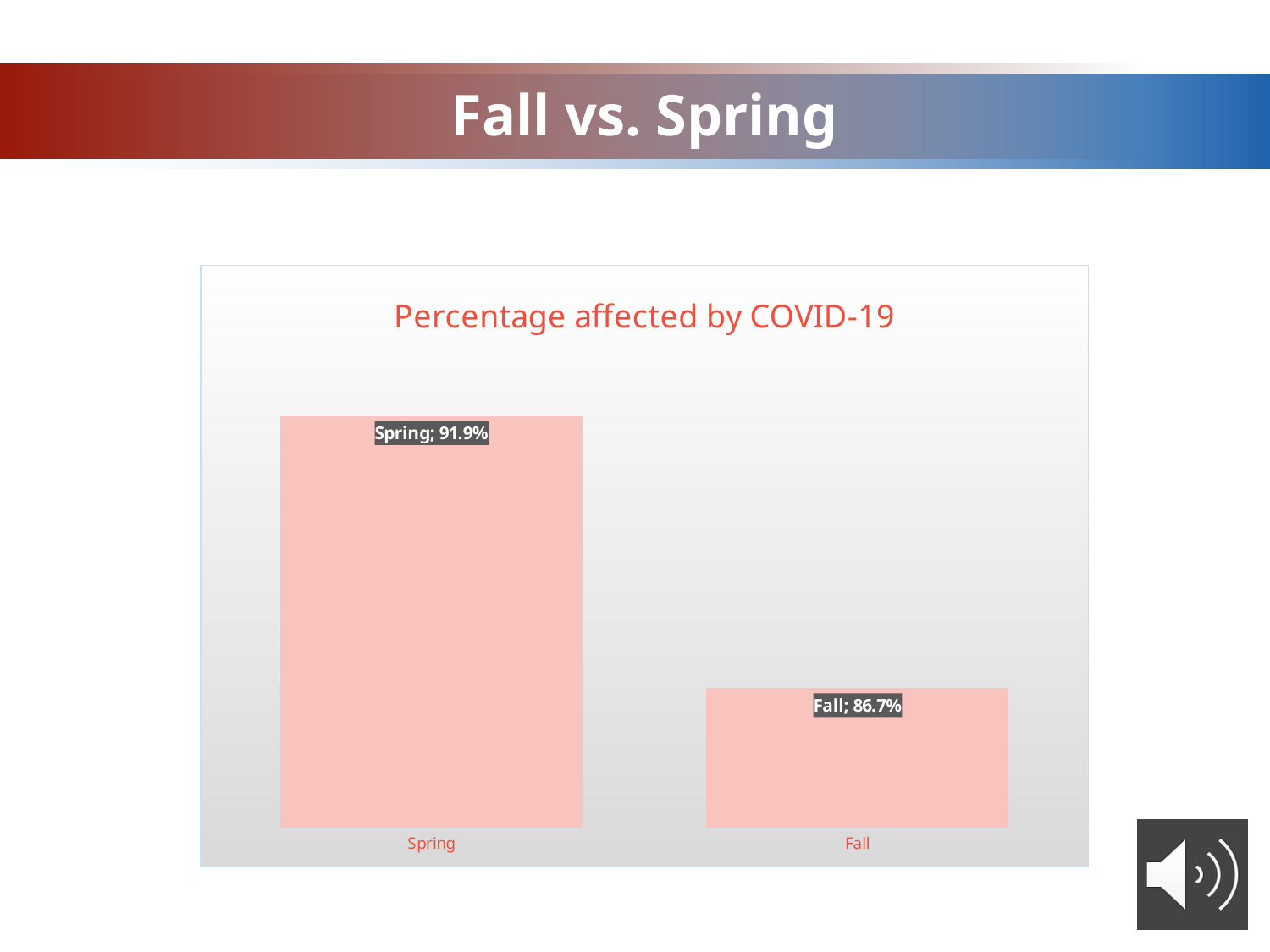
Do the values rise or fall from Spring to Fall along the x axis? fall How many categories are shown in the chart? 2 What is the percentage affected by COVID-19 for Spring? 91.9% What is the difference in percentage points between Spring and Fall? 5.2 What is the title of the chart? Percentage affected by COVID-19 Which category has the lower percentage affected by COVID-19? Fall What is the title of the slide? Fall vs. Spring Which category has the higher percentage affected by COVID-19? Spring What kind of chart is shown on the slide? bar chart What is the percentage affected by COVID-19 for Fall? 86.7% Is the value for Fall larger or smaller than the value for Spring? smaller